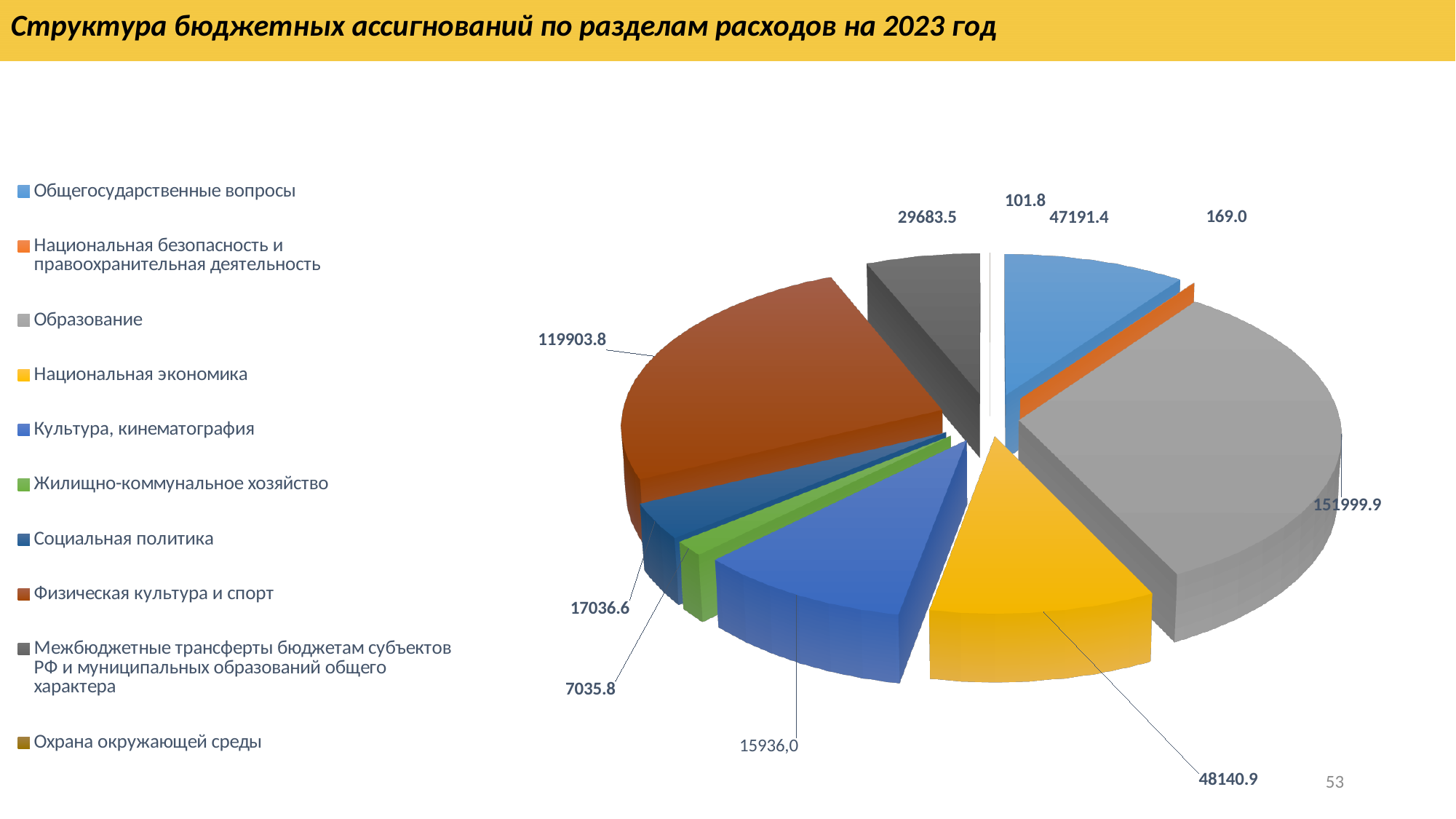
What is the title of the chart? Структура бюджетных ассигнований по разделам расходов на 2023 год What is the value for Жилищно-коммунальное хозяйство? 7035.8 Which is larger, the value for Национальная экономика or the value for Общегосударственные вопросы? Национальная экономика What is the value for Образование? 151999.9 What is the value for Физическая культура и спорт? 119903.8 How many categories does the legend list? 10 What is the value for Межбюджетные трансферты бюджетам субъектов РФ и муниципальных образований общего характера? 29683.5 What is the difference between the values for Образование and Физическая культура и спорт? 32096.1 Which category has the largest value? Образование What is the value for Культура, кинематография? 15936,0 Which category has the smallest value? Охрана окружающей среды What kind of chart is shown on the slide? pie chart